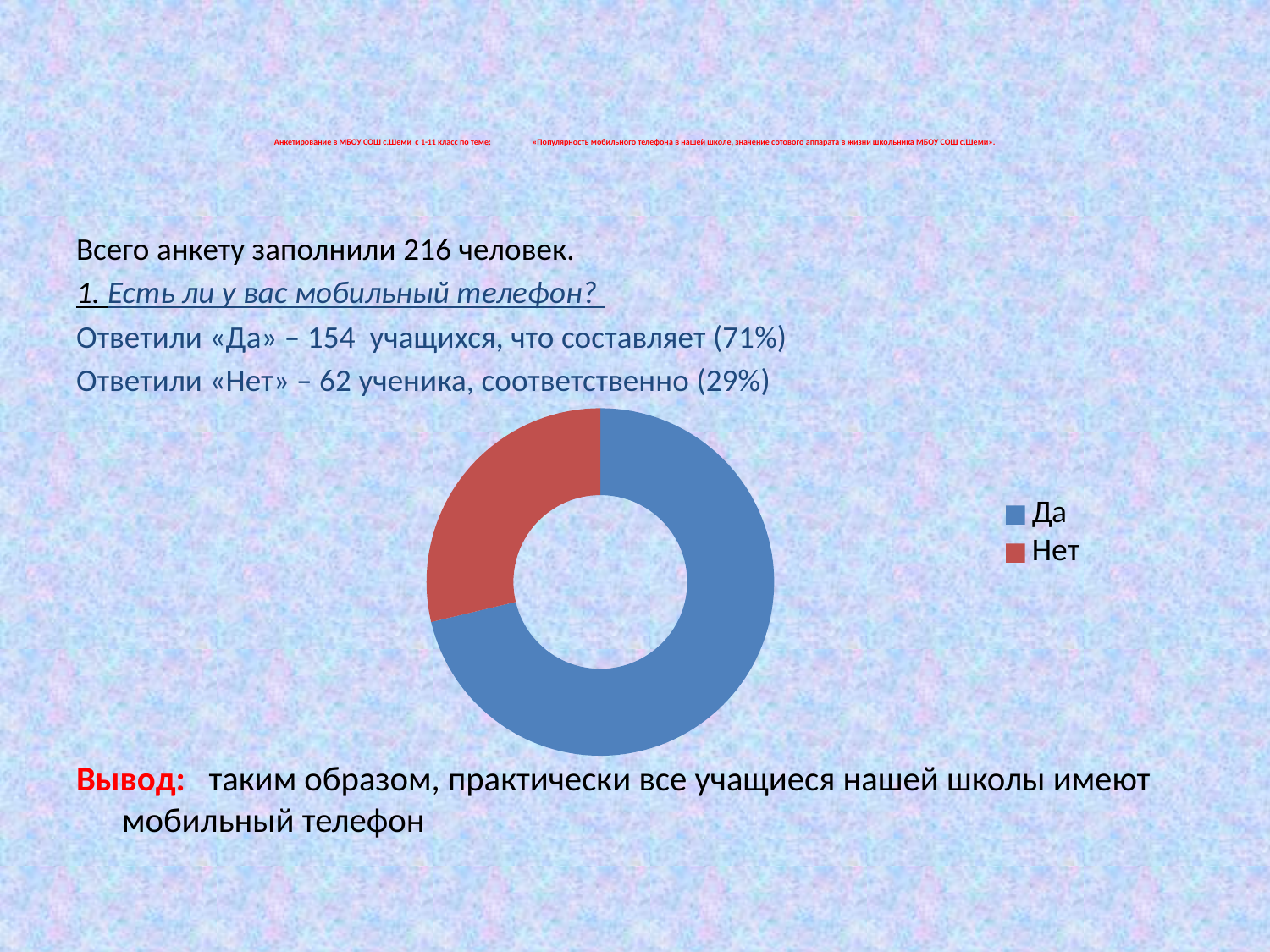
What kind of chart is shown on the slide? doughnut chart Which slice is larger, Да or Нет? Да Which category has the smallest slice in the chart? Нет What is the difference between the number of Да and Нет answers? 92 According to the slide, how many students answered Нет? 62 According to the slide, how many students answered Да? 154 According to the slide, what share of respondents answered Да? 71% Which category has the largest slice in the chart? Да What colour is the Нет slice in the chart? red What is the total number of respondents represented in the chart? 216 According to the slide, what share of respondents answered Нет? 29% How many categories does the chart's legend list? 2